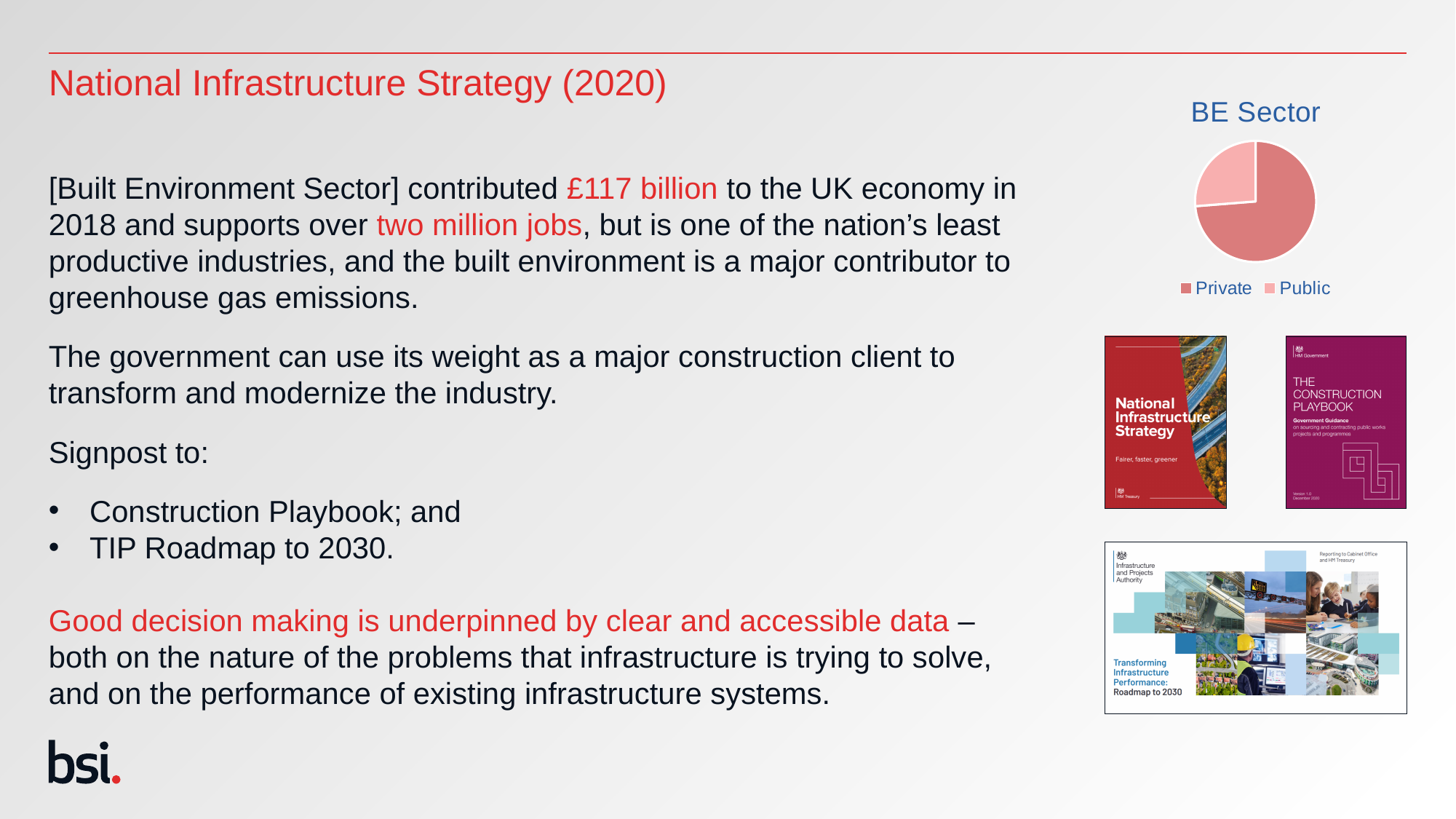
How many entries does the legend of the BE Sector pie chart list? 2 How many slices does the BE Sector pie chart have? 2 What is the title of the pie chart on the slide? BE Sector Which category has the smallest slice in the BE Sector pie chart? Public What are the two categories shown in the legend of the BE Sector pie chart? Private and Public In the BE Sector pie chart, which slice is larger, Private or Public? Private What kind of chart is shown under the title "BE Sector"? Pie chart Which category has the largest slice in the BE Sector pie chart? Private